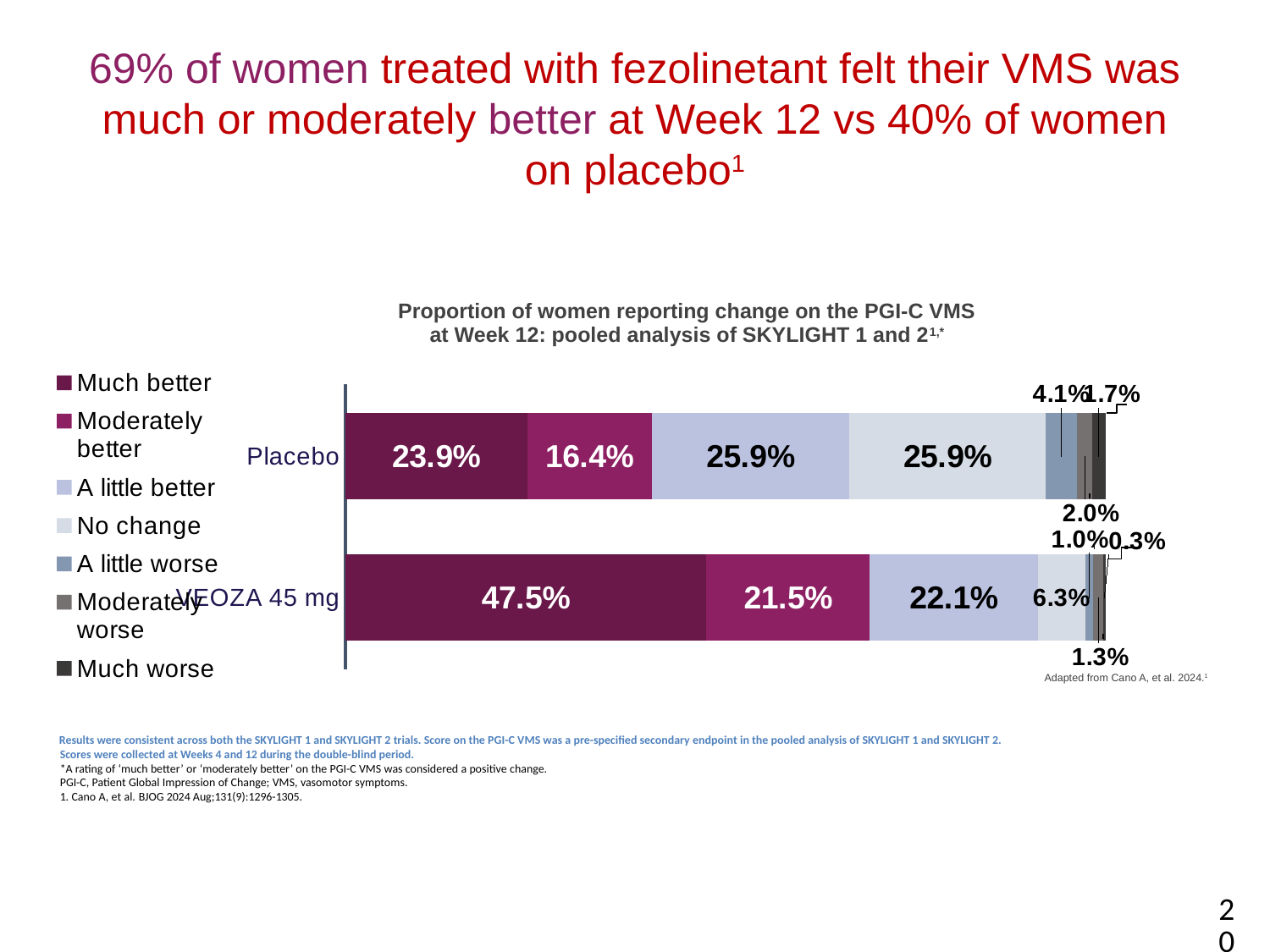
What percentage of women on Placebo reported 'Moderately better'? 16.4% Which group had the larger 'Much better' proportion, Placebo or VEOZA 45 mg? VEOZA 45 mg What is the difference in the 'No change' proportion between Placebo and VEOZA 45 mg? 19.6% What percentage of women on VEOZA 45 mg reported 'No change'? 6.3% How many series does the legend list? 7 What is the difference in the 'Much better' proportion between VEOZA 45 mg and Placebo? 23.6% How many treatment groups (bars) are plotted in the chart? 2 What percentage of women on VEOZA 45 mg reported 'Much better'? 47.5% What is the title of the chart? Proportion of women reporting change on the PGI-C VMS at Week 12: pooled analysis of SKYLIGHT 1 and 2 What type of chart is shown on the slide? Stacked bar chart Which response category is the largest segment in the VEOZA 45 mg bar? Much better What percentage of women on Placebo reported 'Much better'? 23.9%